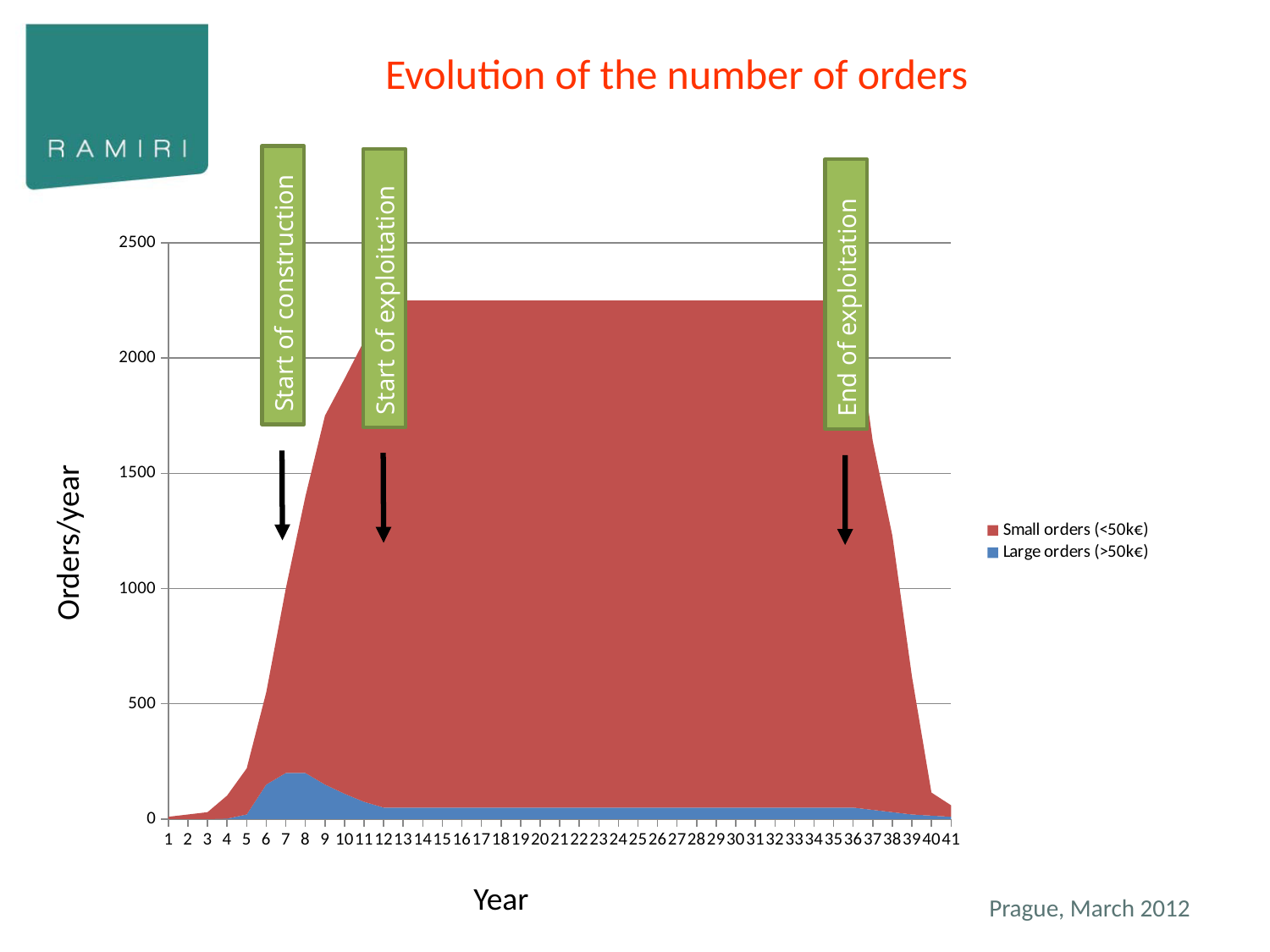
What kind of chart is shown on the slide? Area chart What is the title of the chart? Evolution of the number of orders Is the value for Large orders (>50k€) in year 7 greater or less than 500? less How many series does the legend list? 2 How many years are shown along the x axis? 41 Is the total number of orders in year 40 greater or less than 500? less Do the total orders rise or fall from year 36 to year 41? fall Is the total number of orders in year 20 greater or less than 2000? greater In year 20, which series is larger: Small orders (<50k€) or Large orders (>50k€)? Small orders (<50k€) What are the two series named in the legend? Small orders (<50k€) and Large orders (>50k€) Do the total orders rise or fall from year 1 to year 13? rise